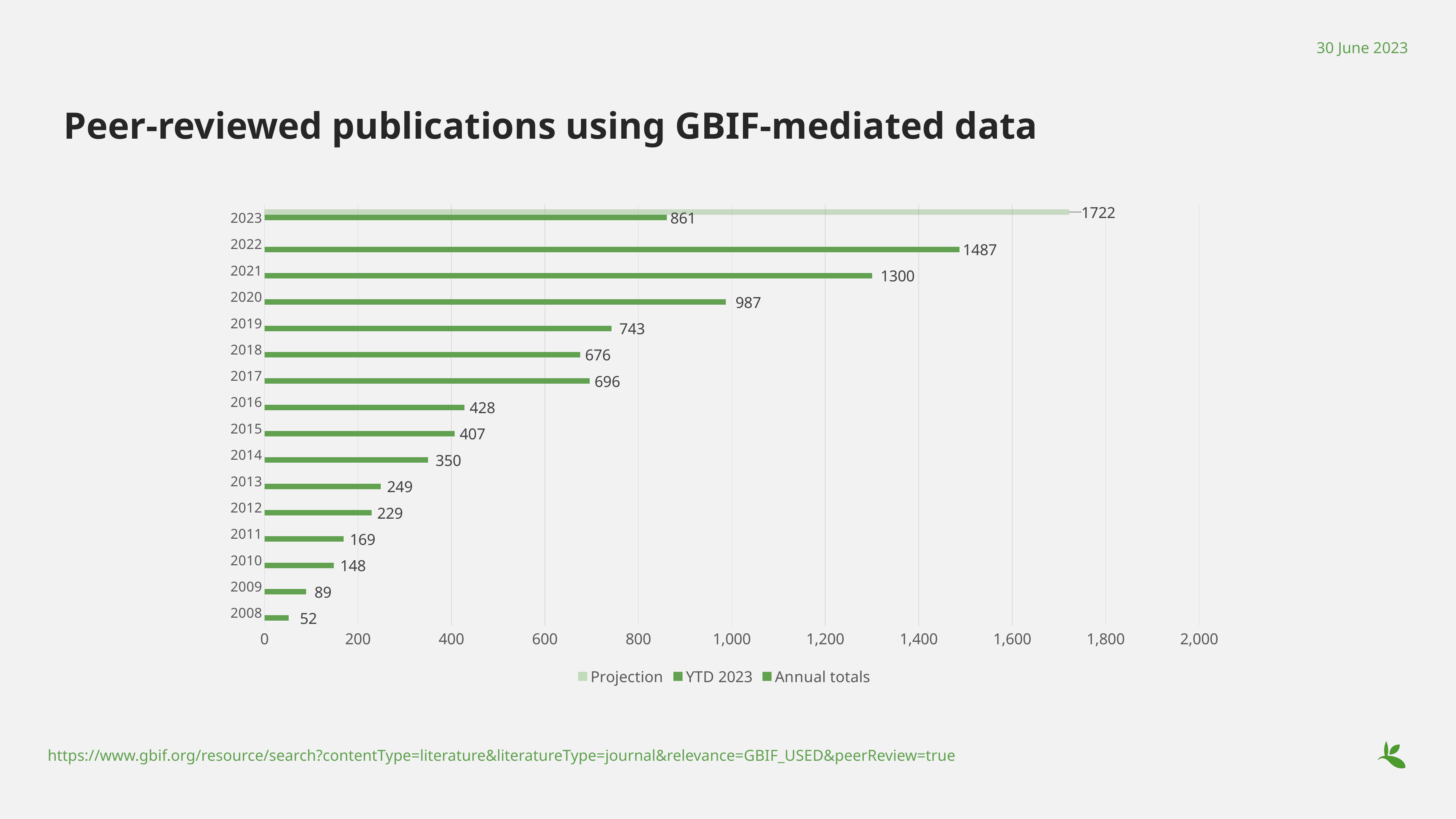
What kind of chart is shown on the slide? Bar chart Which year has the highest annual total (excluding the 2023 YTD and projection bars)? 2022 How many series does the legend list? 3 What is the annual total for 2008? 52 Which year has the lowest annual total? 2008 What is the annual total of peer-reviewed publications for 2022? 1487 What is the projection value for 2023? 1722 What is the YTD 2023 value shown on the chart? 861 Do the annual totals generally rise or fall from 2008 to 2022? Rise What is the difference between the annual totals for 2022 and 2021? 187 Which is larger, the annual total for 2017 or for 2018? 2017 How many years are listed on the vertical axis? 16